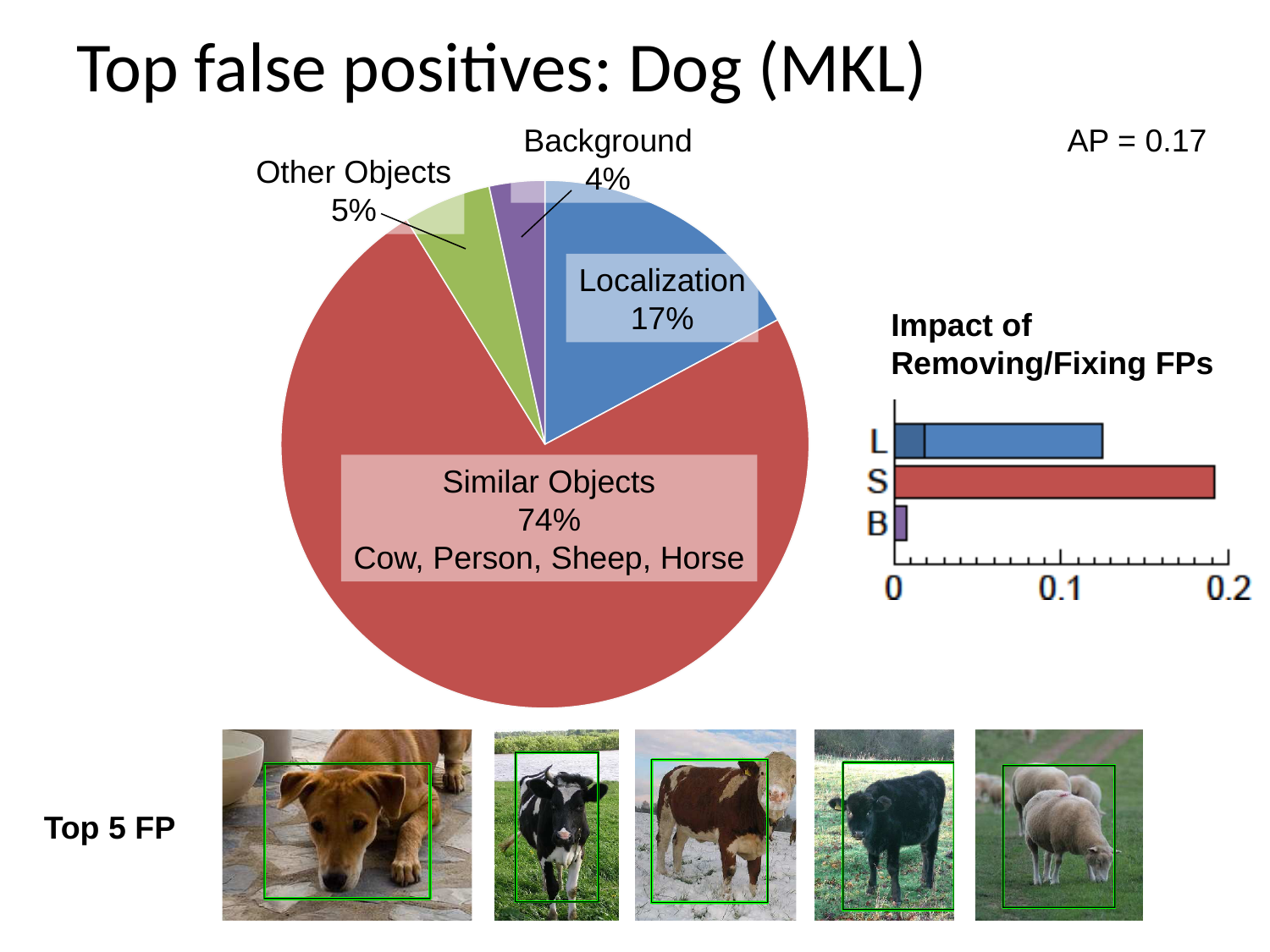
In the pie chart, which category has the smallest share? Background In the pie chart, what share of false positives is attributed to Background? 4% What kind of chart is the 'Impact of Removing/Fixing FPs' chart? bar chart In the pie chart, what share of false positives is attributed to Similar Objects? 74% In the 'Impact of Removing/Fixing FPs' chart, which category has the longest bar? S In the pie chart, which category has the largest share? Similar Objects In the 'Impact of Removing/Fixing FPs' chart, is the value for L greater or less than 0.1? greater In the pie chart, what share of false positives is attributed to Other Objects? 5% How many slices does the pie chart have? 4 In the pie chart, what share of false positives is attributed to Localization? 17% In the pie chart, what is the difference in percentage points between Similar Objects and Localization? 57 In the pie chart, which similar object classes are listed under Similar Objects? Cow, Person, Sheep, Horse